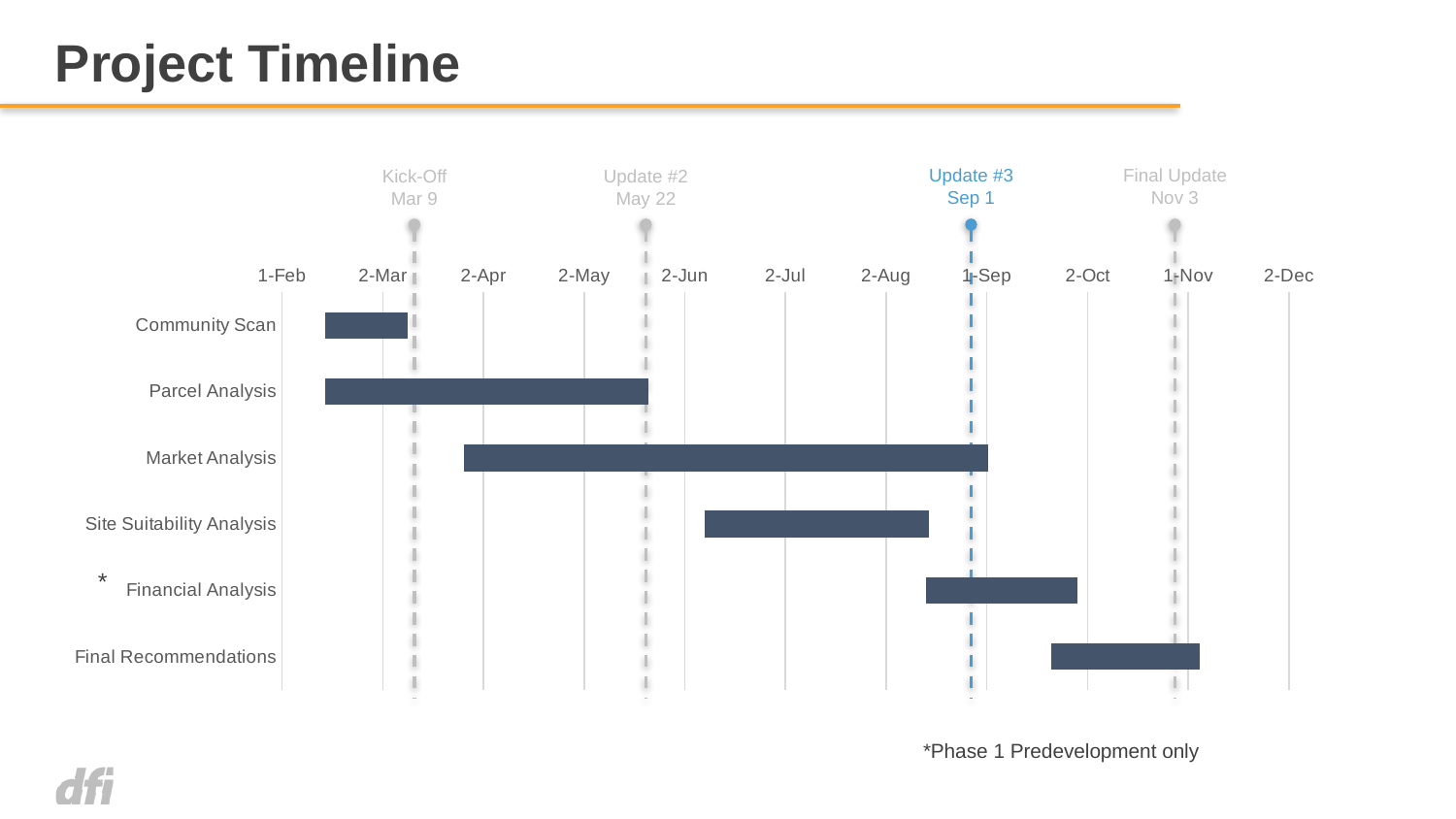
Which task has the longest bar on the timeline? Market Analysis Which task starts earlier, Market Analysis or Site Suitability Analysis? Market Analysis How many milestones are marked above the timeline? 4 Which task ends later, Financial Analysis or Final Recommendations? Final Recommendations What is the date of the Update #3 milestone? Sep 1 How many tasks are listed on the vertical axis of the timeline? 6 Which milestone label is highlighted in blue? Update #3 What is the date of the Kick-Off milestone? Mar 9 What kind of chart is shown on the slide? bar chart Which task has the shortest bar on the timeline? Community Scan What is the date of the Final Update milestone? Nov 3